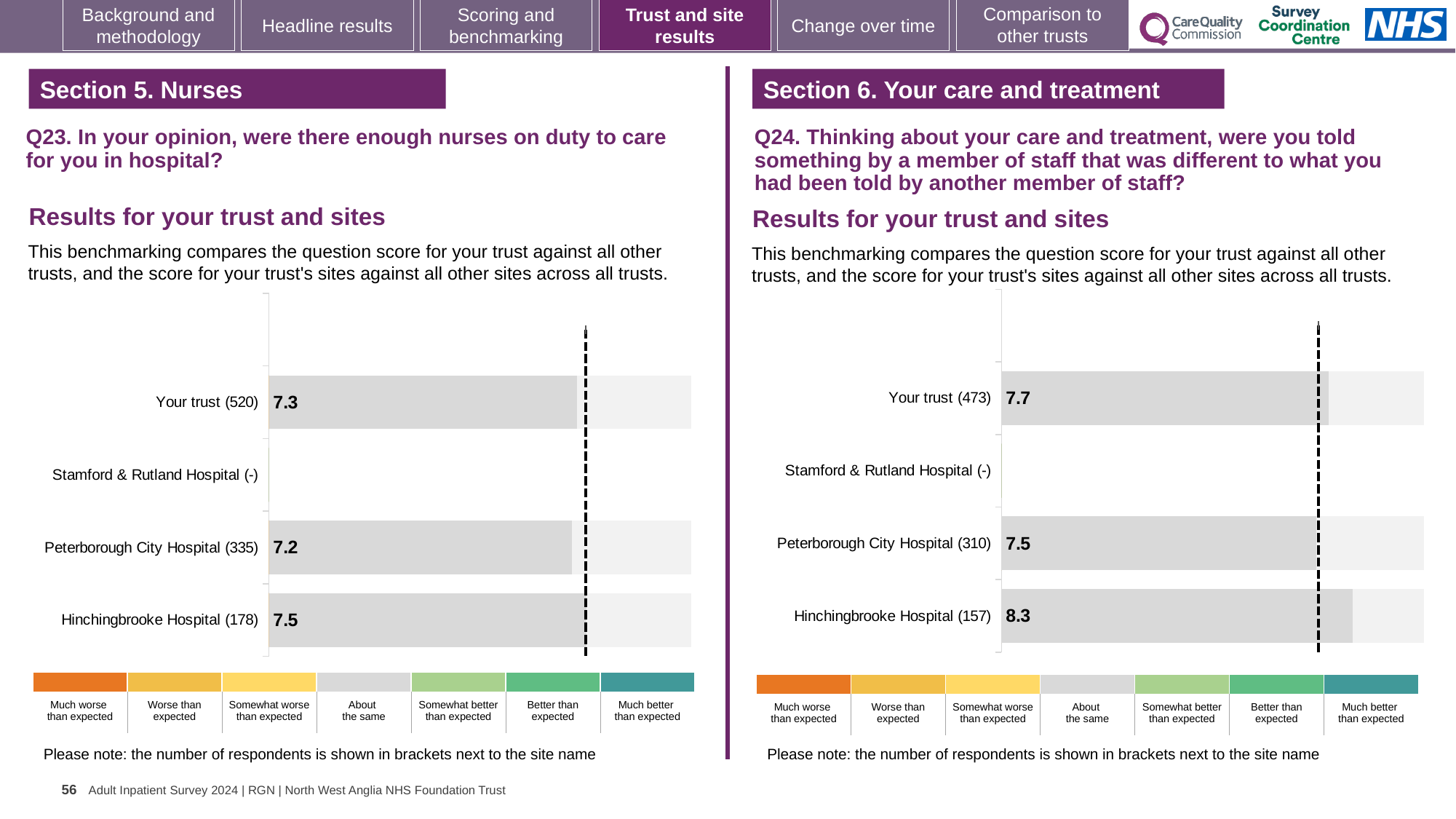
In the Q23 chart on the left, what is the score for Hinchingbrooke Hospital? 7.5 How many sites or trusts are listed on the y axis of the Q23 chart on the left? 4 In the Q23 chart on the left, what is the score for Your trust? 7.3 In the Q24 chart on the right, which has the larger score, Your trust or Peterborough City Hospital? Your trust In the Q24 chart on the right, what is the score for Hinchingbrooke Hospital? 8.3 In the Q23 chart on the left, which site or trust has the lowest printed score? Peterborough City Hospital In the Q24 chart on the right, what is the difference between the scores for Hinchingbrooke Hospital and Your trust? 0.6 In the Q23 chart on the left, which site or trust has the highest score? Hinchingbrooke Hospital In the Q24 chart on the right, which site or trust has the highest score? Hinchingbrooke Hospital What kind of chart is the Q24 chart on the right? Bar chart In the Q24 chart on the right, what is the score for Peterborough City Hospital? 7.5 In the Q23 chart on the left, what is the difference between the scores for Hinchingbrooke Hospital and Peterborough City Hospital? 0.3